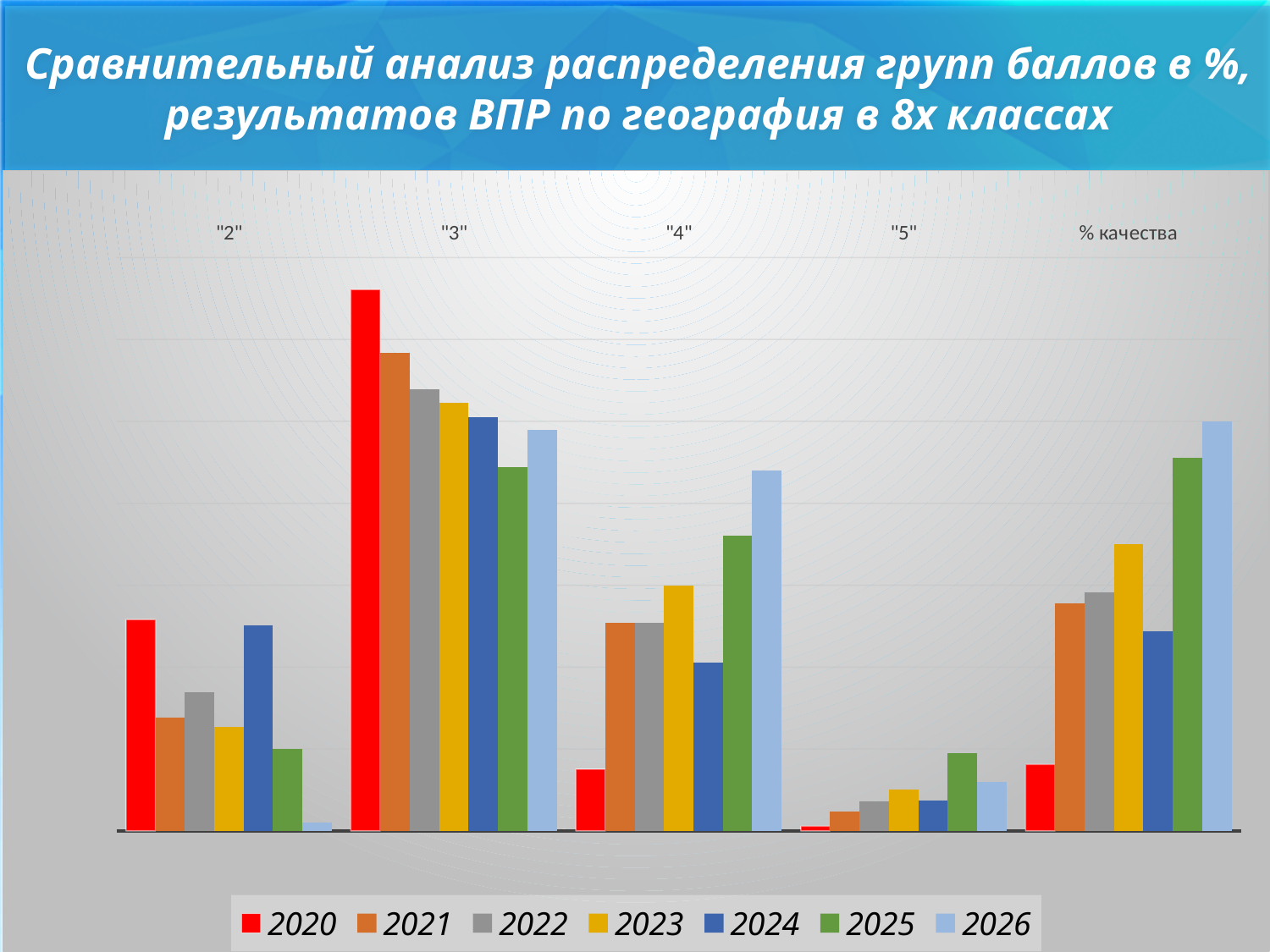
Which colour represents the 2020 series in the legend? red In the "2" category, which is larger: the value for 2020 or the value for 2025? 2020 Which year has the highest value in the "3" category? 2020 Which year has the highest value in the "5" category? 2025 How many series does the legend list? 7 Which year has the lowest value in the "2" category? 2026 Which year has the lowest value in the "5" category? 2020 What kind of chart is shown on the slide? bar chart Which year has the highest value in the "% качества" category? 2026 In the "% качества" category, which is larger: the value for 2025 or the value for 2020? 2025 How many categories are shown along the x axis? 5